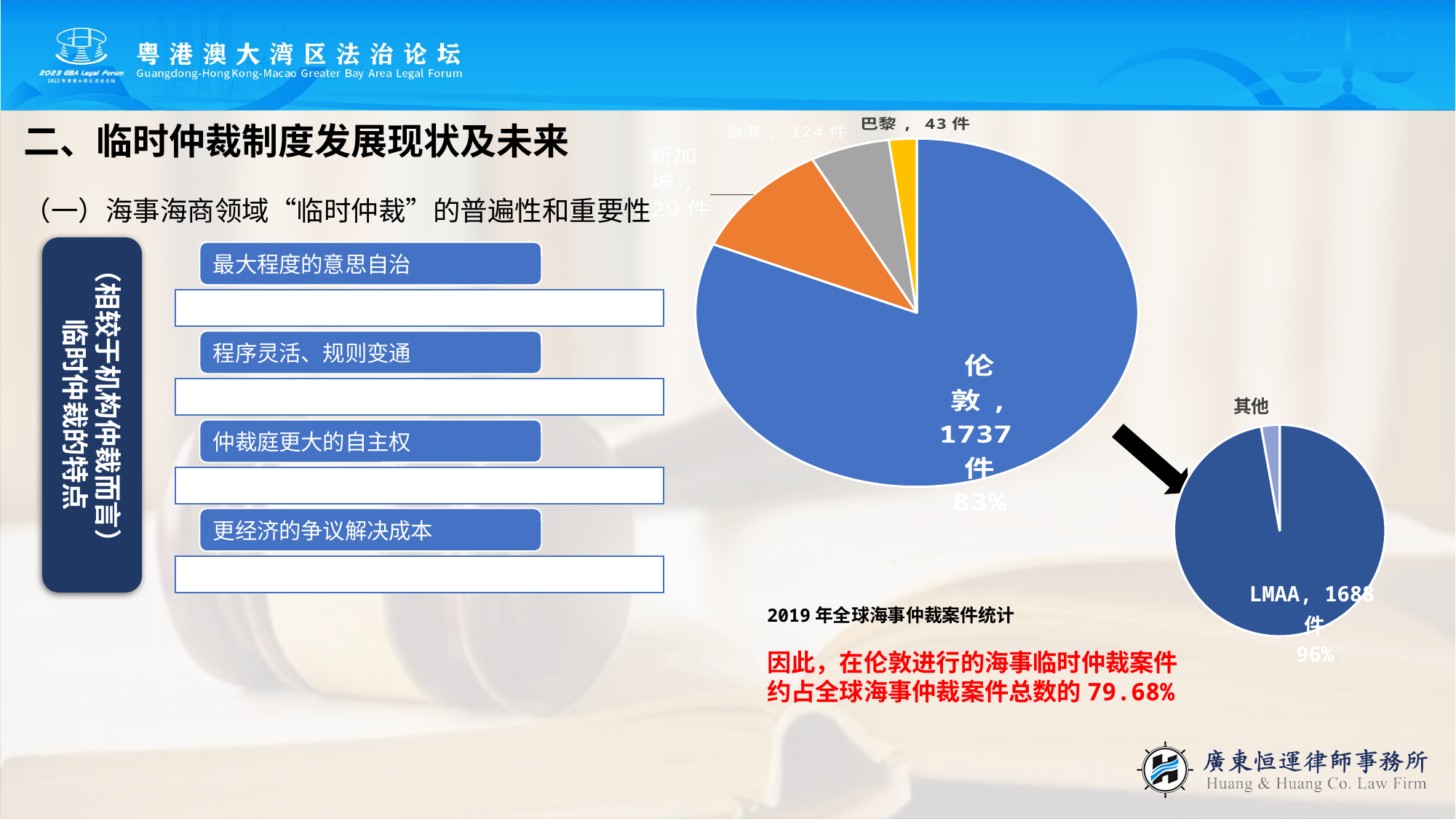
What type of chart is used on the right side of the slide? Pie chart In the large pie chart, which has more cases, 香港 or 巴黎? 香港 What is the title shown below the large pie chart? 2019 年全球海事仲裁案件统计 In the large pie chart (2019 年全球海事仲裁案件统计), how many cases are shown for 伦敦? 1737 件 In the large pie chart, which category has the smallest slice? 巴黎 In the large pie chart, what is the difference between the number of cases for 香港 and 巴黎? 81 件 In the small pie chart at the bottom right, what percentage share is labelled for LMAA? 96% In the large pie chart, which category has the largest slice? 伦敦 In the large pie chart, what percentage share is labelled for 伦敦? 83% In the large pie chart, how many cases are shown for 巴黎? 43 件 In the large pie chart, how many cases are shown for 香港? 124 件 In the small pie chart at the bottom right, how many cases are shown for LMAA? 1688 件